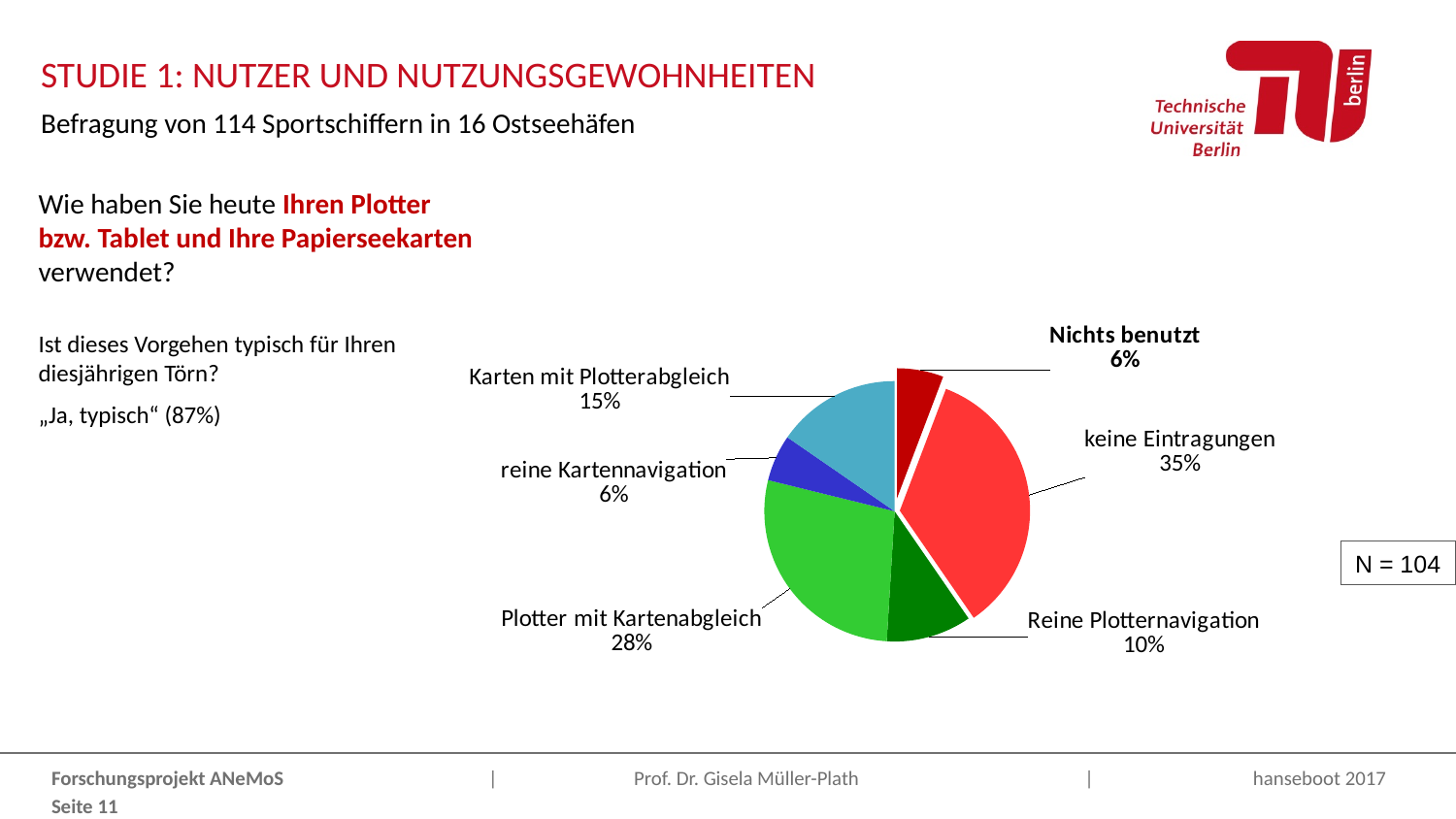
What share of the pie is labelled "keine Eintragungen"? 35% What share of the pie is labelled "Karten mit Plotterabgleich"? 15% Which slice of the pie chart is the largest? keine Eintragungen What is the difference in percentage points between "Karten mit Plotterabgleich" and "Reine Plotternavigation"? 5 How many slices does the pie chart have? 6 Which is larger, the share for "Plotter mit Kartenabgleich" or the share for "Karten mit Plotterabgleich"? Plotter mit Kartenabgleich What share of the pie is labelled "Plotter mit Kartenabgleich"? 28% What kind of chart is shown on the slide? pie chart What sample size (N) is shown next to the pie chart? N = 104 What share of the pie is labelled "Reine Plotternavigation"? 10% What is the difference in percentage points between "keine Eintragungen" and "Plotter mit Kartenabgleich"? 7 What share of the pie is labelled "Nichts benutzt"? 6%